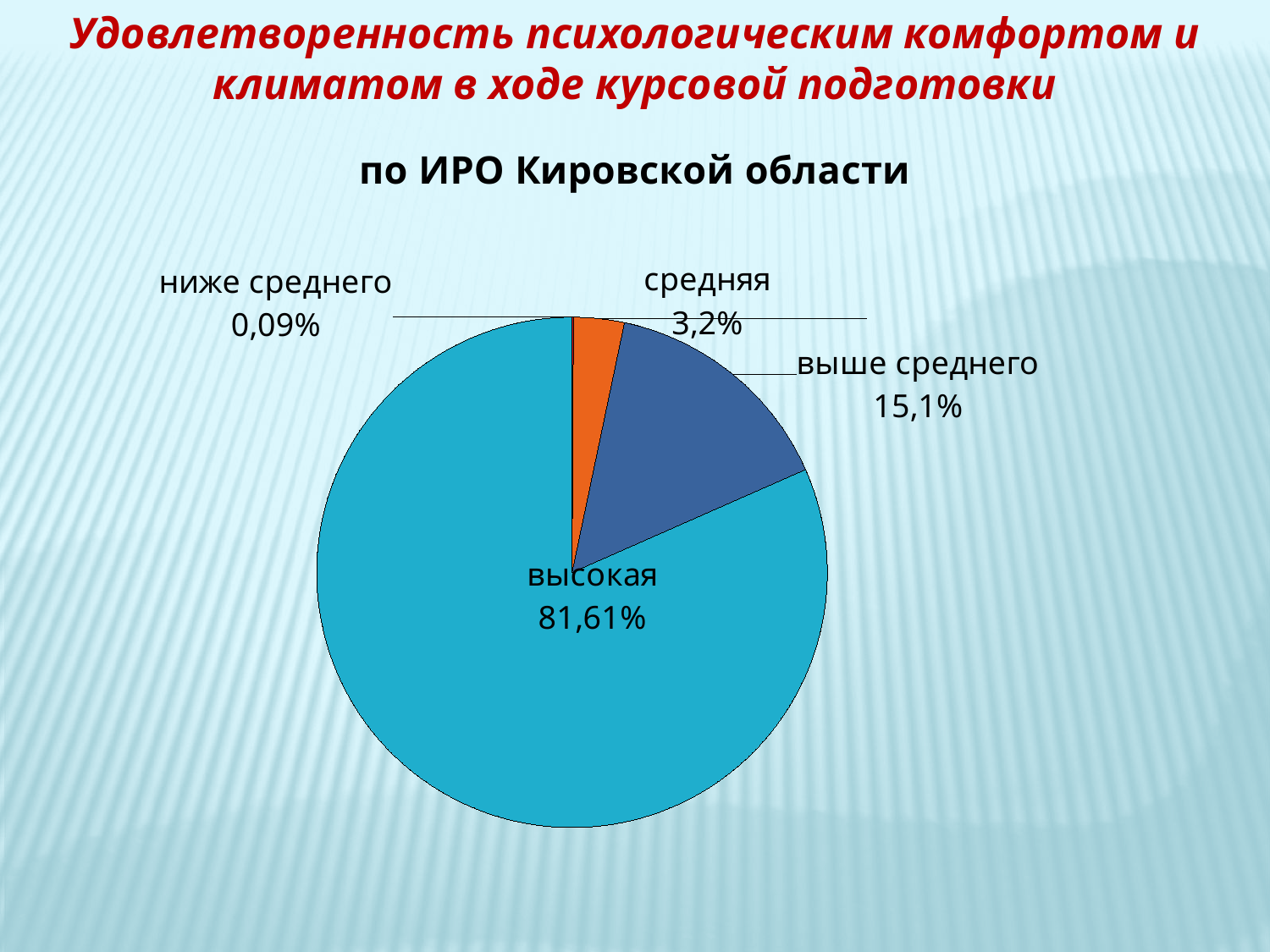
What is the difference between the values for "высокая" and "выше среднего"? 66,51% Which category has the smallest slice of the pie? ниже среднего What share of the pie does the "высокая" slice represent? 81,61% What is the title printed directly above the pie chart? по ИРО Кировской области What type of chart is shown on the slide? pie chart Which is larger, the value for "средняя" or the value for "ниже среднего"? средняя What is the value shown for "средняя"? 3,2% What is the value shown for "ниже среднего"? 0,09% How many slices does the pie chart have? 4 Which category has the largest slice of the pie? высокая What is the value shown for "выше среднего"? 15,1% What is the difference between the values for "выше среднего" and "средняя"? 11,9%